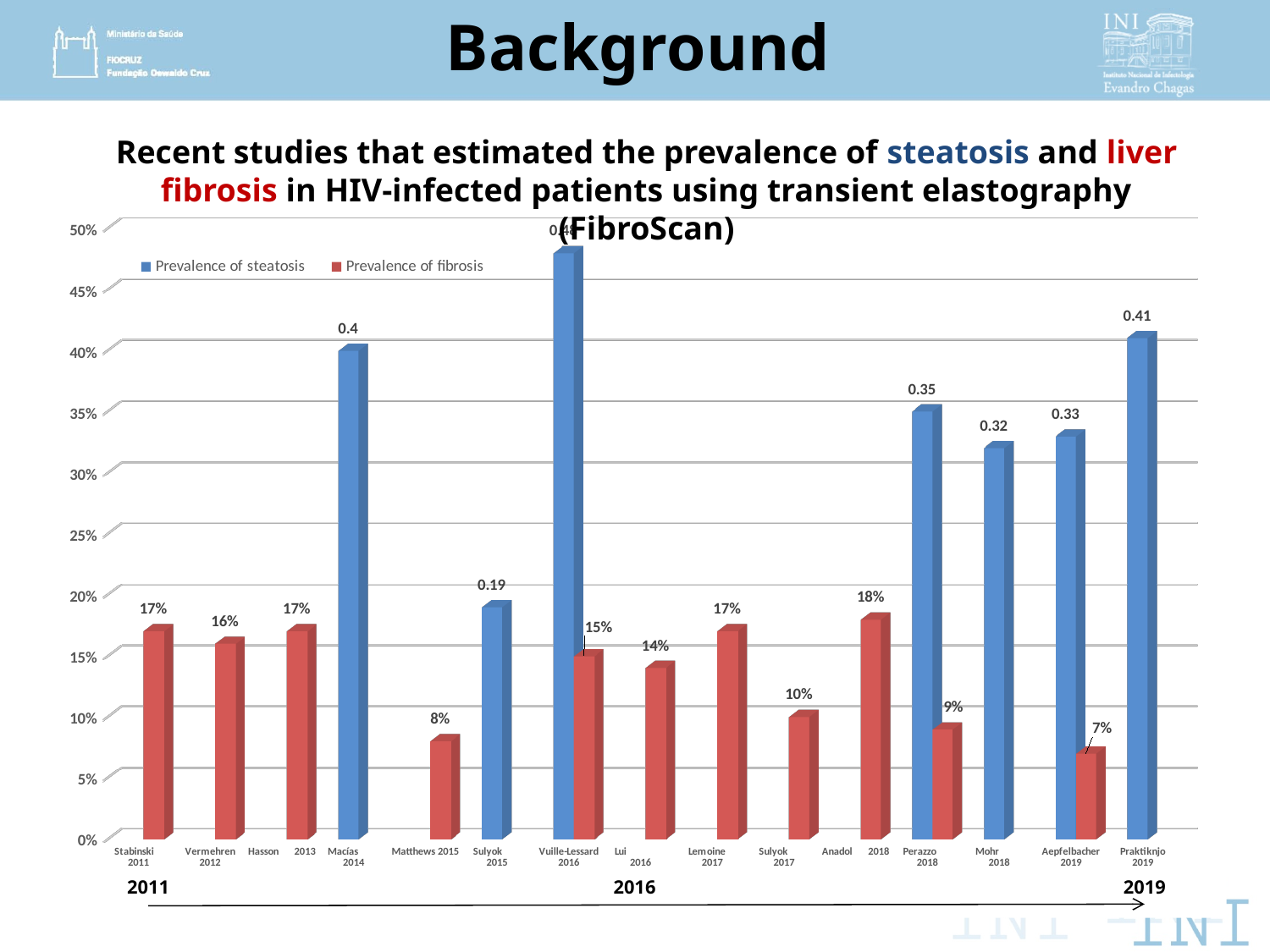
Which study has the highest prevalence of fibrosis? Anadol 2018 What is the difference between the prevalence of steatosis for Perazzo 2018 and Mohr 2018? 0.03 What is the prevalence of steatosis reported for Praktiknjo 2019? 0.41 How many series does the legend list? 2 Which study has the lowest prevalence of fibrosis? Aepfelbacher 2019 Is the prevalence of steatosis for Vuille-Lessard 2016 greater or less than 45%? greater What kind of chart is shown on the slide? bar chart What is the prevalence of fibrosis reported for Matthews 2015? 8% Which study has the lowest prevalence of steatosis? Sulyok 2015 What is the prevalence of steatosis reported for Macías 2014? 0.4 What is the prevalence of fibrosis reported for Anadol 2018? 18% Which has a higher prevalence of fibrosis, Lemoine 2017 or Lui 2016? Lemoine 2017